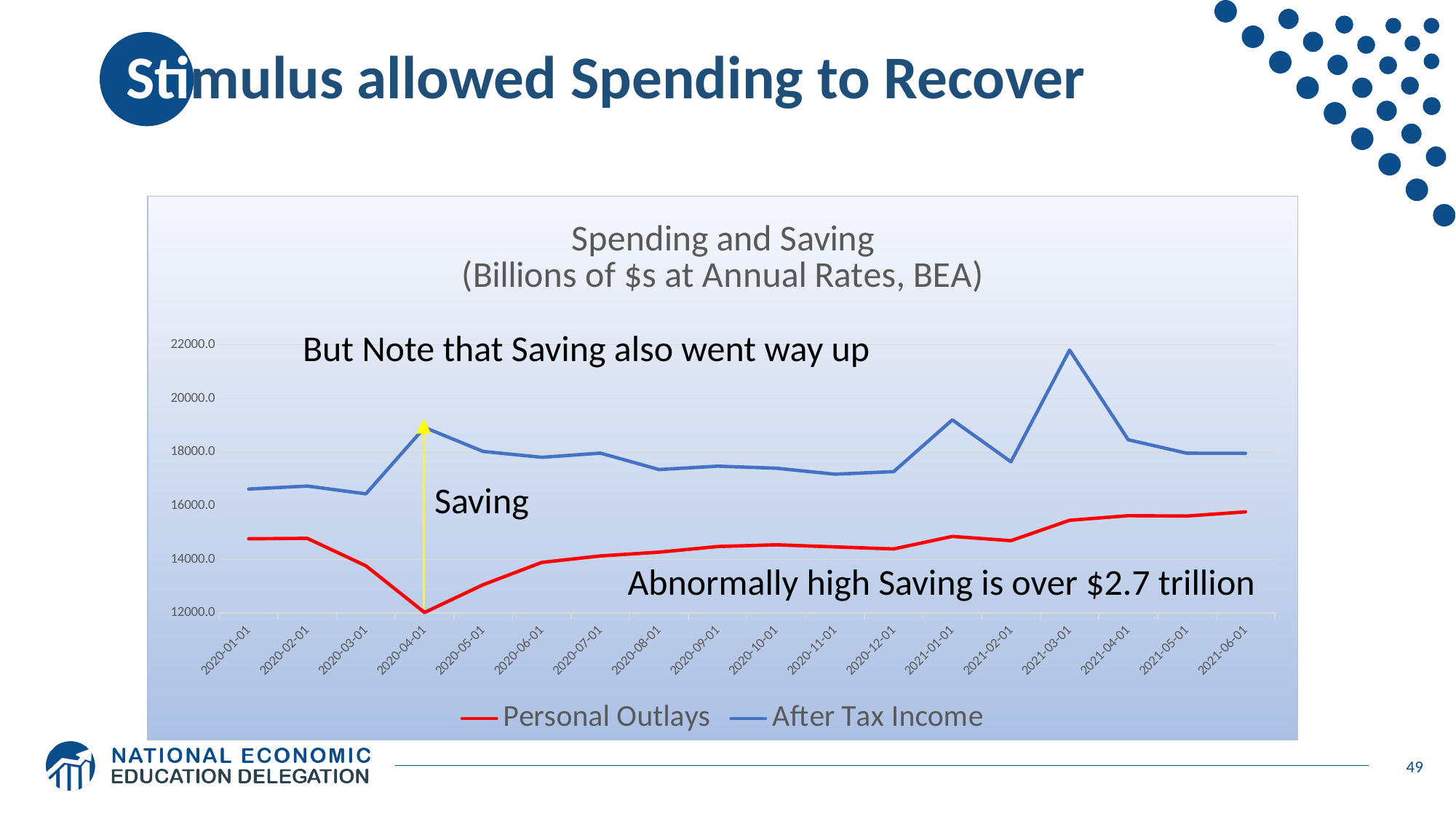
Is the value for Personal Outlays at 2020-04-01 greater or less than 14000.0? less At which date does After Tax Income reach its highest value? 2021-03-01 What is the title of the chart? Spending and Saving (Billions of $s at Annual Rates, BEA) At which date do Personal Outlays reach their lowest value? 2020-04-01 How many series does the chart's legend list? 2 What colour is the Personal Outlays line in the chart? red What kind of chart is shown on the slide? line chart Is the value for After Tax Income at 2020-01-01 greater or less than 18000.0? less Is the value for After Tax Income at 2021-03-01 greater or less than 20000.0? greater How many dates are plotted along the x axis of the chart? 18 At 2020-04-01, which series has the larger value, Personal Outlays or After Tax Income? After Tax Income Do Personal Outlays rise or fall from 2020-04-01 to 2021-06-01? rise